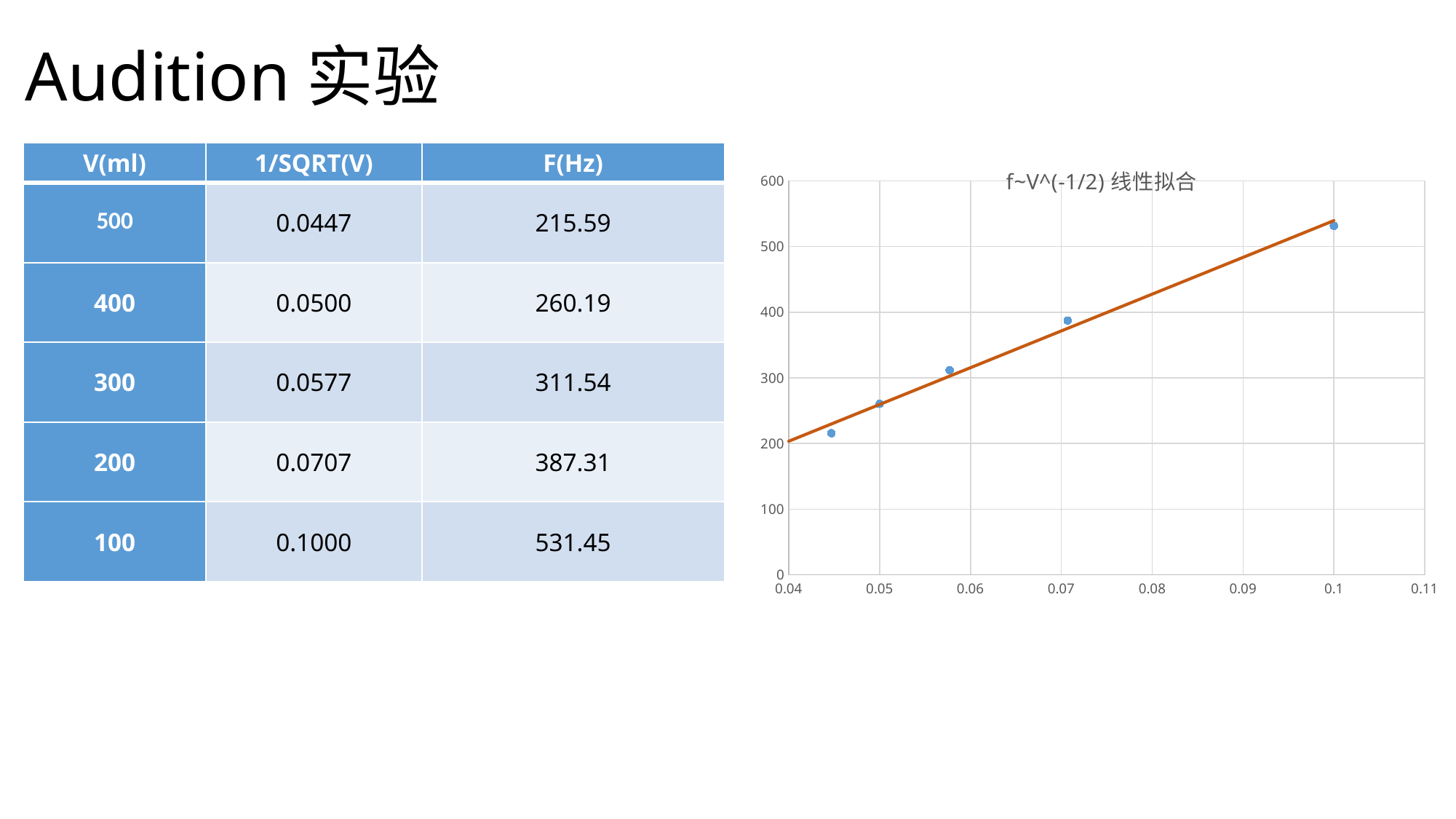
Is the value of the point at x = 0.05 greater or less than 300? less What kind of chart is shown on the slide? scatter chart What is the maximum value shown on the chart's y-axis? 600 At which x-axis value is the highest plotted point? 0.1 What is the title of the chart? f~V^(-1/2) 线性拟合 Do the plotted values rise or fall as the x-axis value increases? rise Is the value of the leftmost point (near x = 0.045) greater or less than 200? greater Is the value of the point at x = 0.1 greater or less than 500? greater How many data points are plotted in the chart? 5 According to the table, what is F(Hz) for V = 500 ml, the lowest point in the chart? 215.59 According to the table, what is F(Hz) for V = 100 ml, the highest point in the chart? 531.45